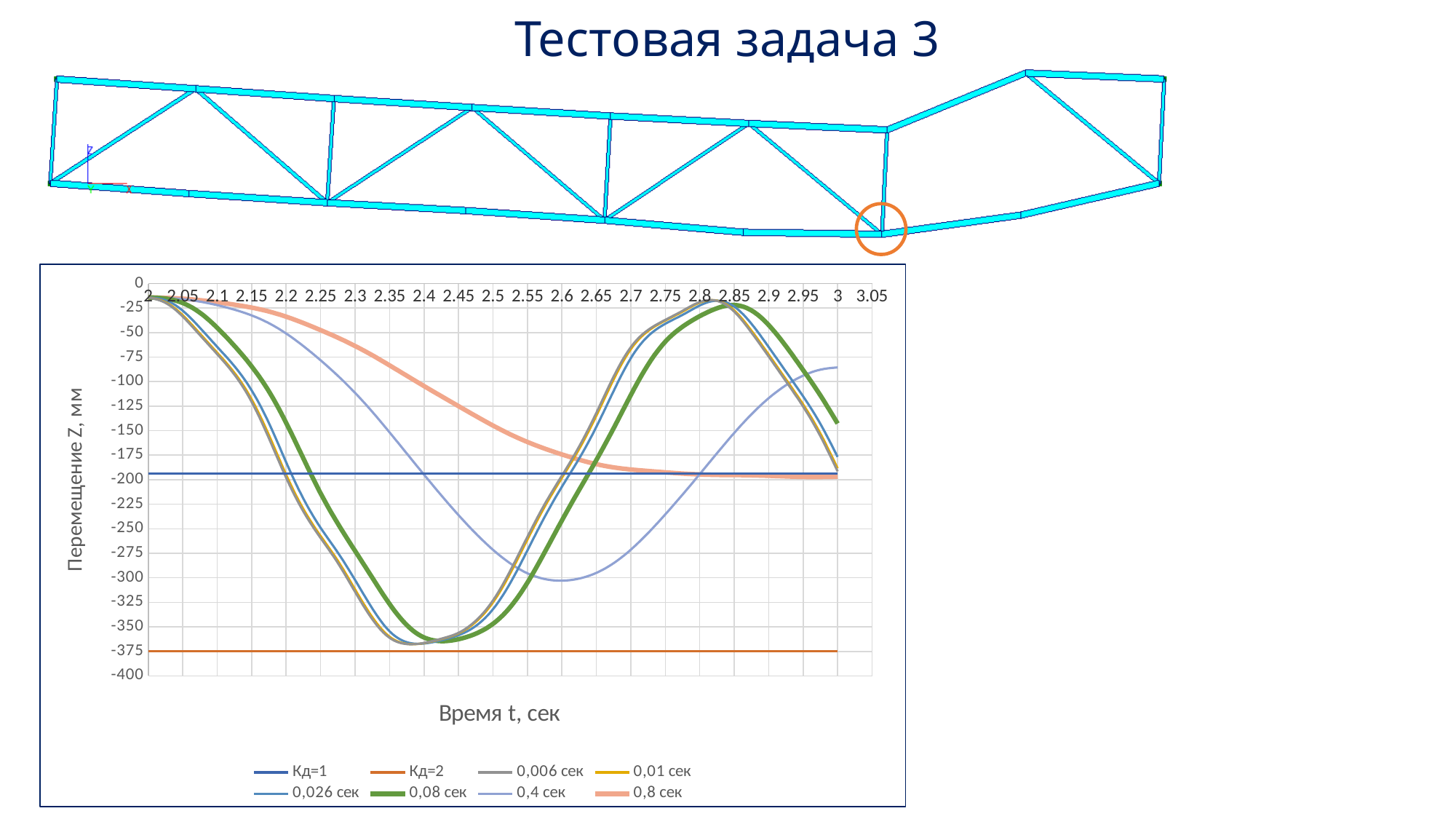
How many series does the chart legend list? 8 Is the value of the Кд=1 series greater or less than -175? less Does the 0,8 сек series rise or fall as time increases from 2 to 3? fall Is the minimum value of the 0,08 сек series greater or less than -350? less Is the value of the 0,8 сек series at t = 2.2 greater or less than -75? greater What is the constant value of the Кд=2 series? -375 What kind of chart is shown on the slide? line chart What is the label of the horizontal axis? Время t, сек What is the label of the vertical axis? Перемещение Z, мм Which series has the lowest value on the chart? Кд=2 Which series reaches a lower minimum, 0,4 сек or 0,08 сек? 0,08 сек